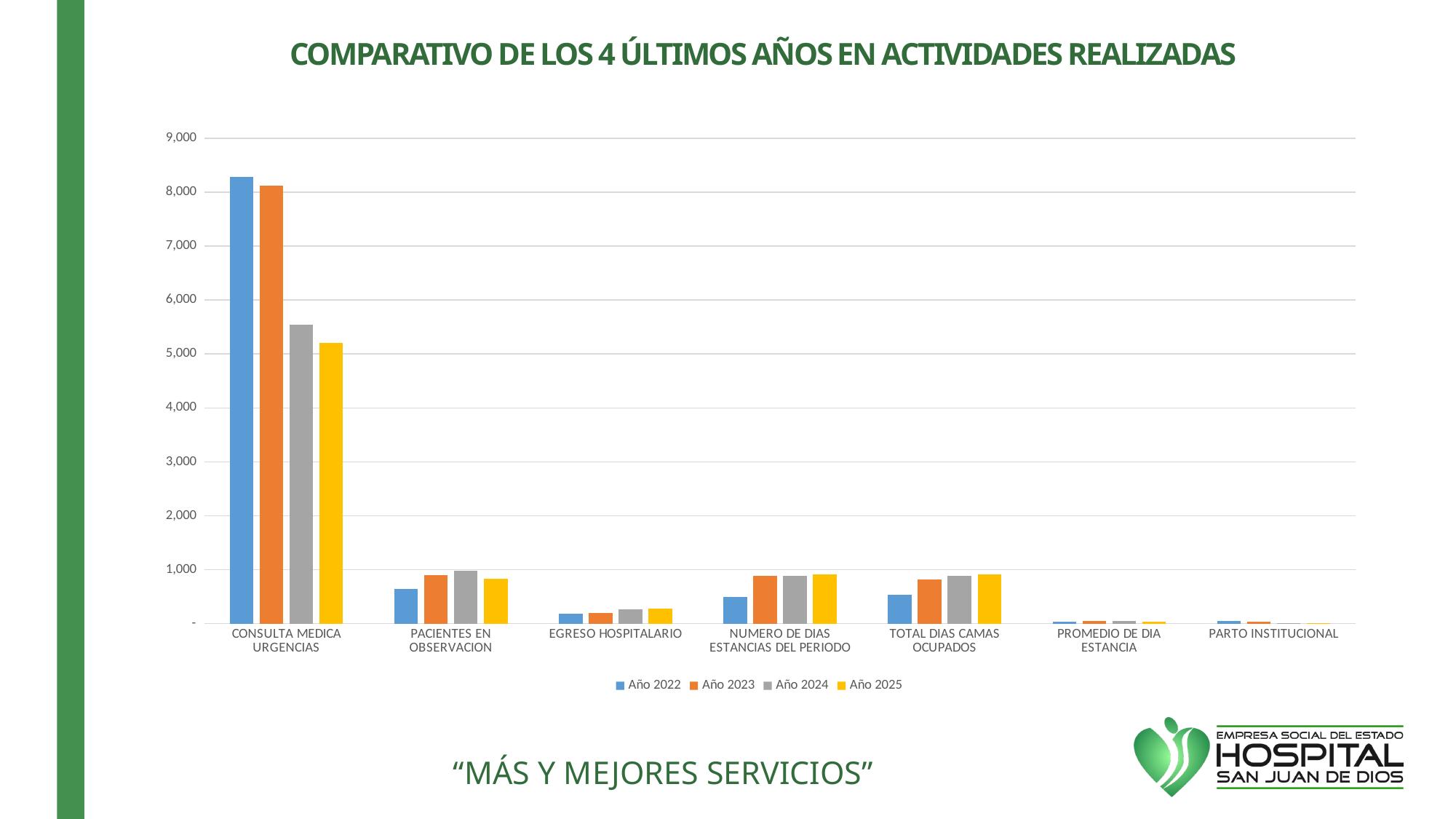
How many categories are shown along the x axis of the chart? 7 What kind of chart is shown on the slide? Bar chart Which category has the highest bars in the chart? CONSULTA MEDICA URGENCIAS For PACIENTES EN OBSERVACION, which is larger: the value for Año 2022 or Año 2024? Año 2024 Is the value for CONSULTA MEDICA URGENCIAS in Año 2024 greater or less than 5,000? greater Is the value for PACIENTES EN OBSERVACION in Año 2022 greater or less than 1,000? less What colour represents Año 2025 in the chart legend? Yellow For Año 2023, which category has the larger value: EGRESO HOSPITALARIO or PACIENTES EN OBSERVACION? PACIENTES EN OBSERVACION How many series does the chart legend list? 4 Is the value for CONSULTA MEDICA URGENCIAS in Año 2022 greater or less than 8,000? greater For CONSULTA MEDICA URGENCIAS, which is larger: the value for Año 2022 or Año 2024? Año 2022 Do the values for CONSULTA MEDICA URGENCIAS rise or fall from Año 2022 to Año 2025? Fall